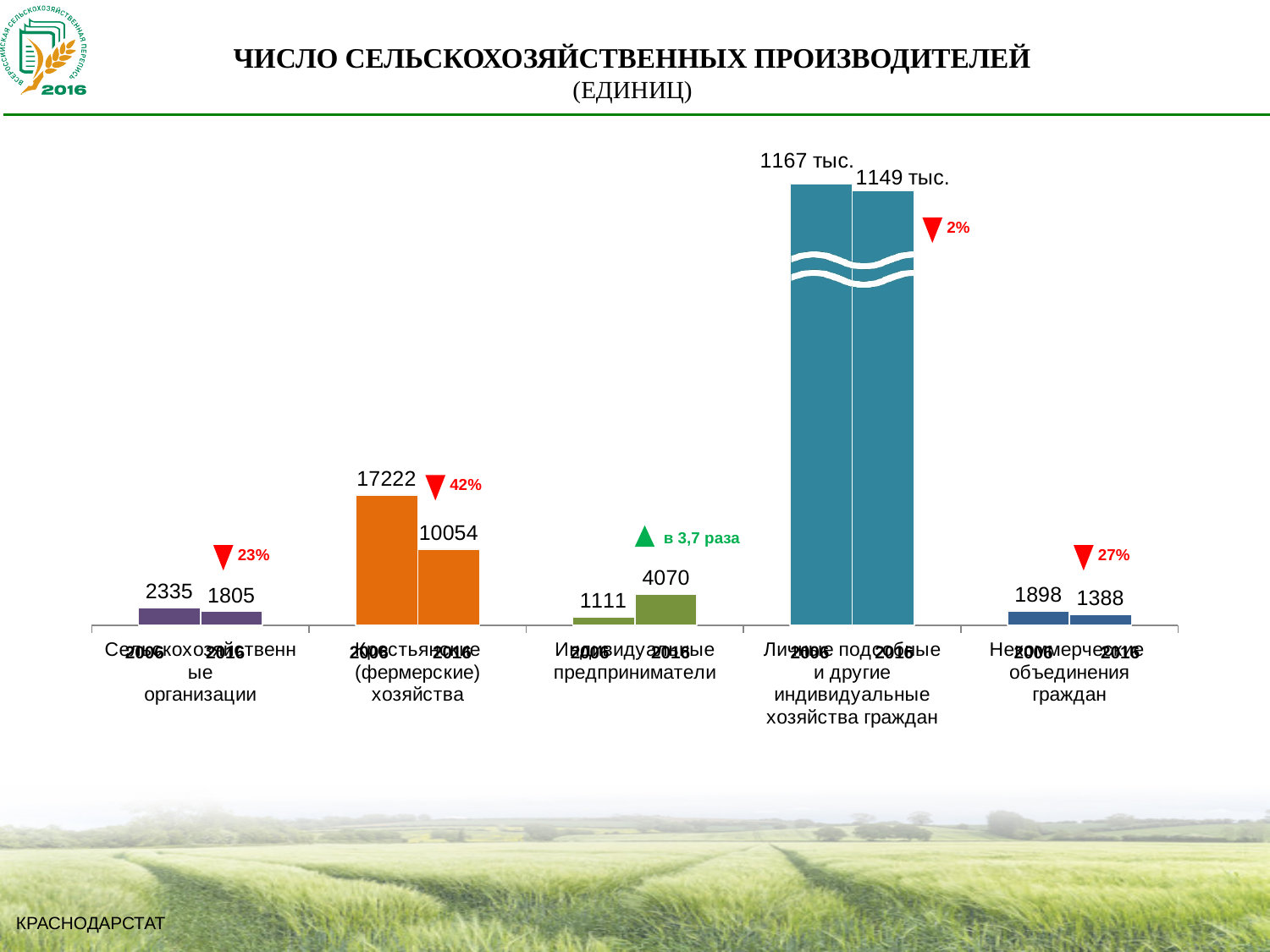
What kind of chart is shown on the slide? bar chart What is the difference between the 2006 and 2016 values for Крестьянские (фермерские) хозяйства? 7168 What percentage change is shown for Сельскохозяйственные организации? 23% What is the value for Личные подсобные и другие индивидуальные хозяйства граждан in 2006? 1167 тыс. What is the value for Индивидуальные предприниматели in 2016? 4070 How many categories are shown on the chart? 5 Which category has the highest values on the chart? Личные подсобные и другие индивидуальные хозяйства граждан What is the value for Некоммерческие объединения граждан in 2016? 1388 What is the value for Крестьянские (фермерские) хозяйства in 2016? 10054 What is the value for Сельскохозяйственные организации in 2006? 2335 Which is larger for Индивидуальные предприниматели: the 2006 value or the 2016 value? 2016 What is the difference between the 2006 and 2016 values for Некоммерческие объединения граждан? 510